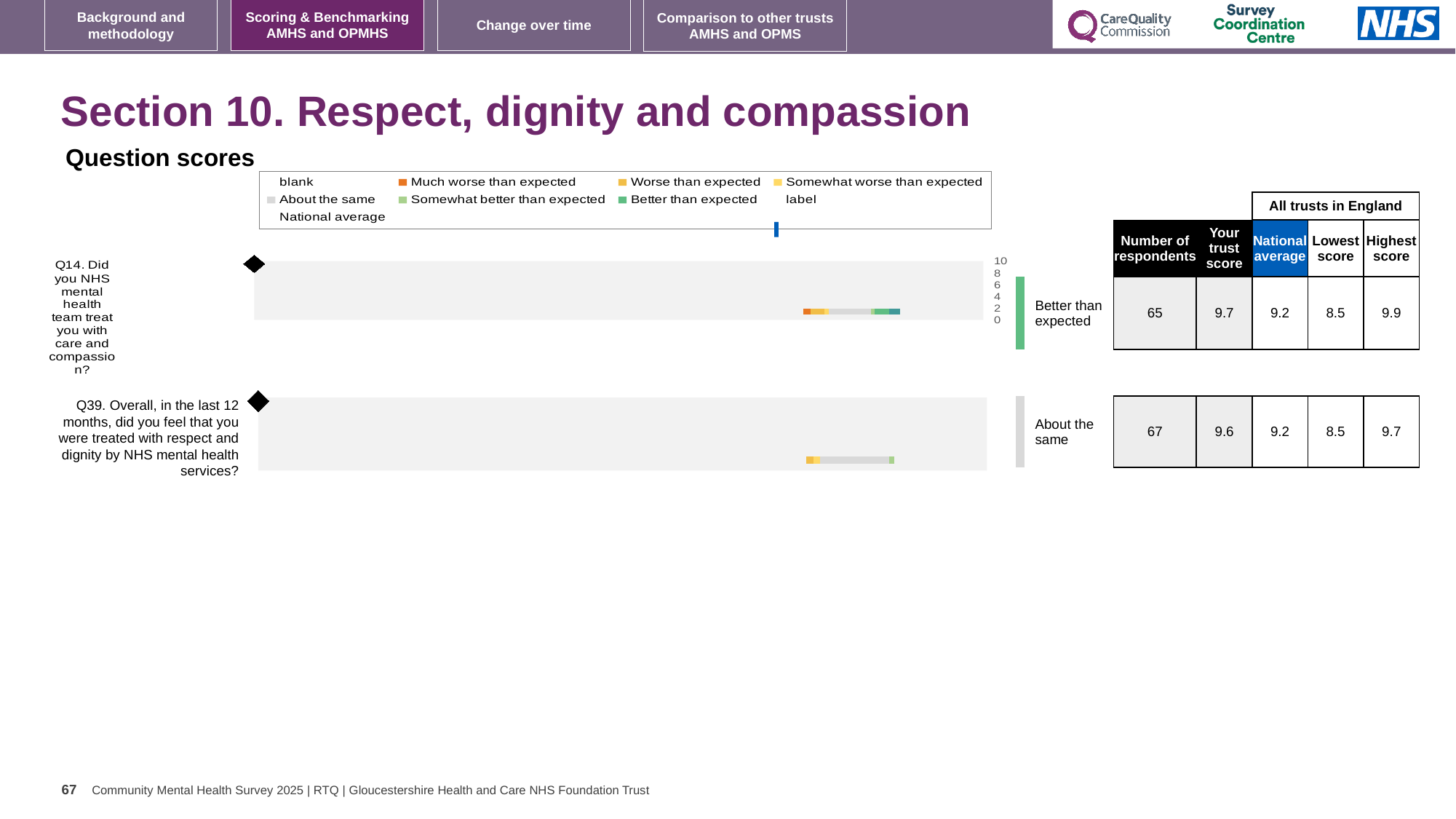
How many respondents are shown for Q39 (respect and dignity)? 67 What is the national average score for Q14? 9.2 How many respondents are shown for Q14 (care and compassion)? 65 How is the trust's result for Q14 categorised relative to expectations? Better than expected What is the trust's score for Q14 (care and compassion)? 9.7 What is the trust's score for Q39 (respect and dignity)? 9.6 By how much does the trust's score for Q14 exceed the national average? 0.5 What is the highest score among all trusts in England for Q14? 9.9 How many questions are plotted on the slide? 2 How is the trust's result for Q39 categorised relative to expectations? About the same Which question has the higher trust score, Q14 or Q39? Q14 What is the lowest score among all trusts in England for Q39? 8.5